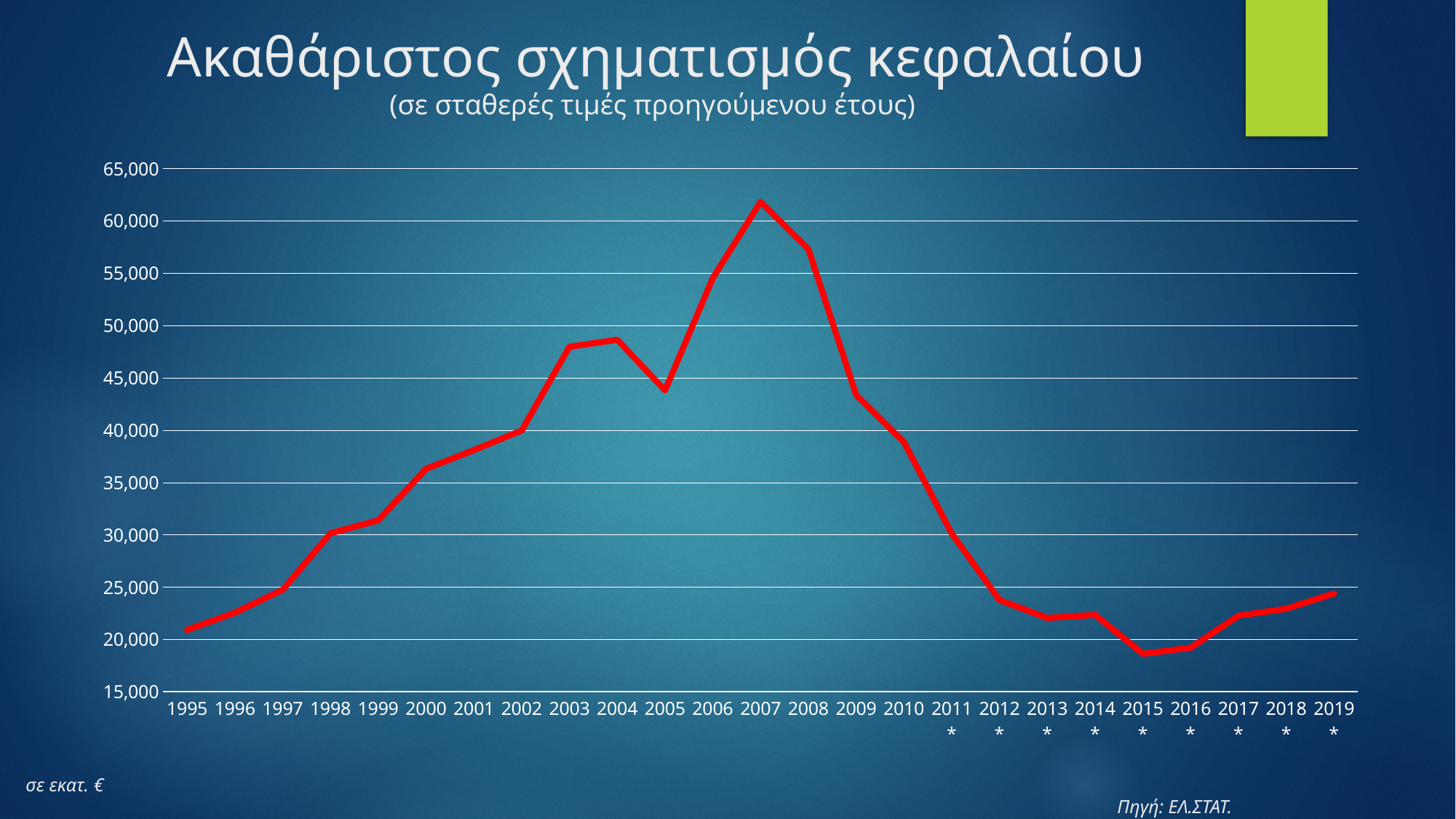
Is the value for 2012 greater or less than 25,000? less Is the value for 2008 greater or less than 55,000? greater How many years are plotted along the x axis? 25 What kind of chart is shown on the slide? line chart Is the value for 2007 greater or less than 60,000? greater In which year does the line reach its highest value? 2007 What is the title of the chart? Ακαθάριστος σχηματισμός κεφαλαίου Which year has the larger value, 2003 or 2005? 2003 Do the values rise or fall between 2007 and 2015? fall Which year has the larger value, 1995 or 2019? 2019